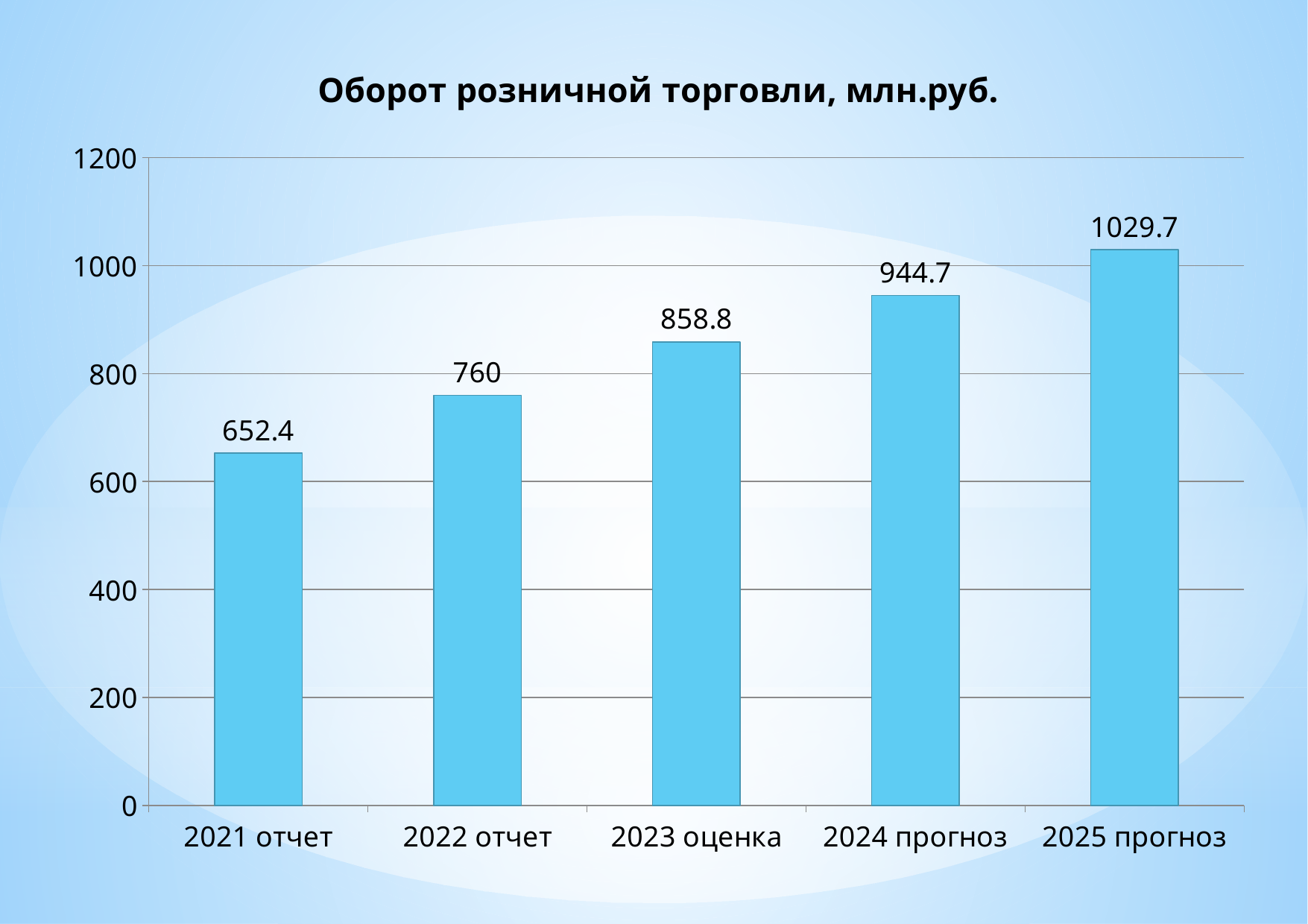
What is the difference between the values for 2025 прогноз and 2024 прогноз? 85 What is the difference between the values for 2022 отчет and 2021 отчет? 107.6 What is the value for 2025 прогноз? 1029.7 Do the values rise or fall from 2021 отчет to 2025 прогноз? rise What is the value for 2021 отчет? 652.4 Which category has the highest value? 2025 прогноз Is the value for 2022 отчет greater or less than 800? less Which category has the lowest value? 2021 отчет Which is larger, the value for 2023 оценка or the value for 2024 прогноз? 2024 прогноз What kind of chart is shown on the slide? bar chart How many categories are shown on the x axis? 5 What is the value for 2023 оценка? 858.8